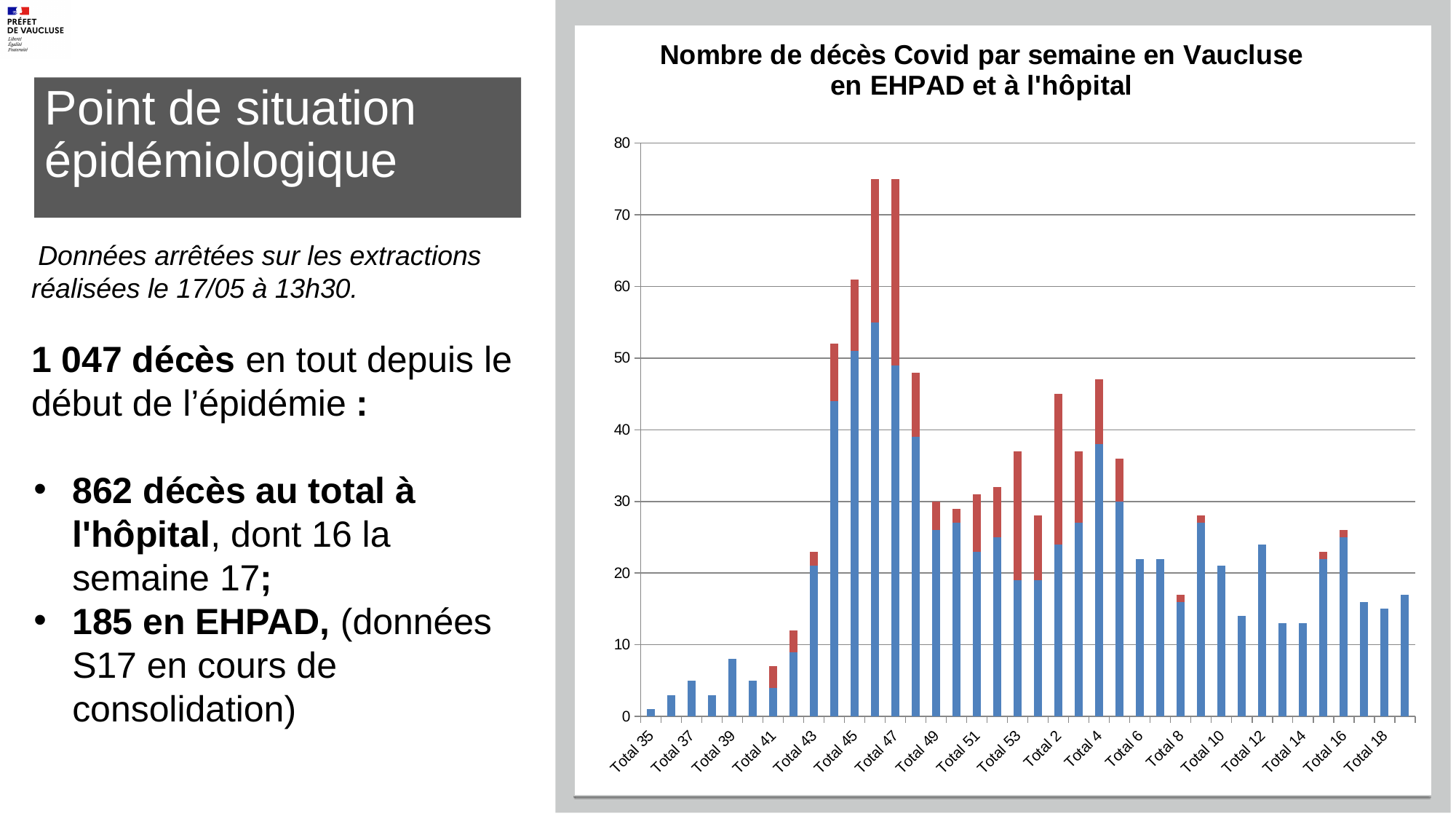
Is the value for Total 2 greater or less than 40? greater Which is larger, the value for Total 43 or the value for Total 53? Total 53 Is the value for Total 14 greater or less than 20? less Is the value for Total 35 greater or less than 10? less Which is larger, the value for Total 47 or the value for Total 2? Total 47 What is the title of the chart? Nombre de décès Covid par semaine en Vaucluse en EHPAD et à l'hôpital Do the values rise or fall from Total 47 to Total 49? fall What kind of chart is shown on the slide? bar chart Which category has the lowest value on the chart? Total 35